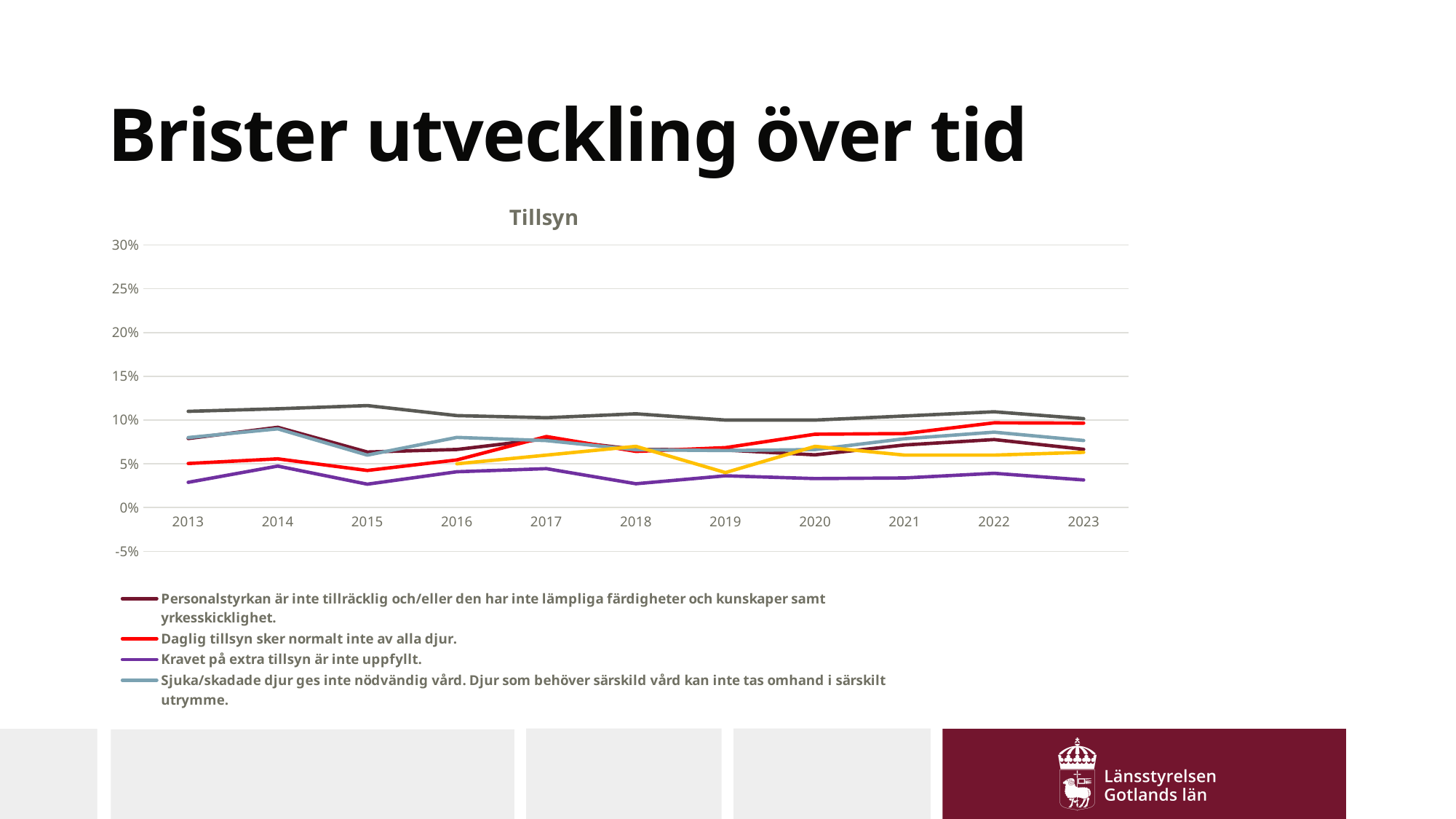
In which year is the line for "Daglig tillsyn sker normalt inte av alla djur." at its lowest? 2015 How many years are plotted along the x axis of the "Tillsyn" chart? 11 Is the value for "Kravet på extra tillsyn är inte uppfyllt." in 2013 greater or less than 5%? less In 2023, which is higher: "Daglig tillsyn sker normalt inte av alla djur." or "Kravet på extra tillsyn är inte uppfyllt."? Daglig tillsyn sker normalt inte av alla djur. Does the line for "Daglig tillsyn sker normalt inte av alla djur." rise or fall from 2015 to 2022? rise What kind of chart is shown under the title "Tillsyn"? line chart Is the value for "Personalstyrkan är inte tillräcklig..." in 2014 greater or less than 5%? greater Is the value for "Daglig tillsyn sker normalt inte av alla djur." in 2015 greater or less than 5%? less What colour is the line for "Daglig tillsyn sker normalt inte av alla djur."? red In which year is the line for "Kravet på extra tillsyn är inte uppfyllt." at its highest? 2014 How many series does the legend of the "Tillsyn" chart list? 4